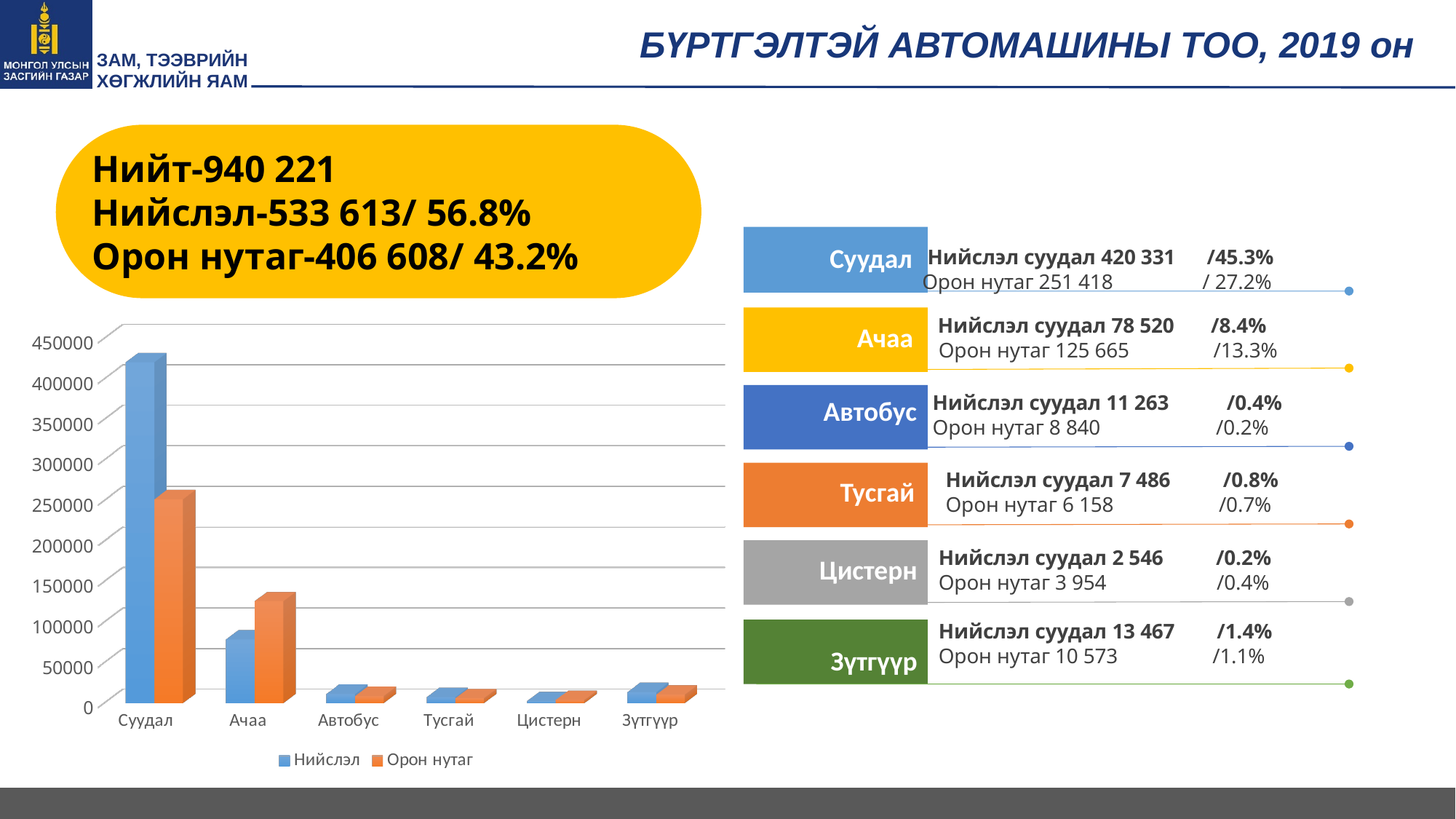
Is the Орон нутаг value for Суудал greater or less than 300000? less According to the slide, what is the Нийслэл value for Суудал? 420 331 Is the Нийслэл value for Суудал greater or less than 400000? greater According to the slide, what is the Орон нутаг value for Ачаа? 125 665 What kind of chart is shown on the slide? bar chart Which category has the highest Нийслэл bar? Суудал For Суудал, which series has the larger bar, Нийслэл or Орон нутаг? Нийслэл How many categories are shown on the x axis of the chart? 6 How many series does the chart legend list? 2 What are the two entries in the chart legend? Нийслэл, Орон нутаг For Ачаа, which series has the larger bar, Нийслэл or Орон нутаг? Орон нутаг Is the Орон нутаг value for Ачаа greater or less than 100000? greater